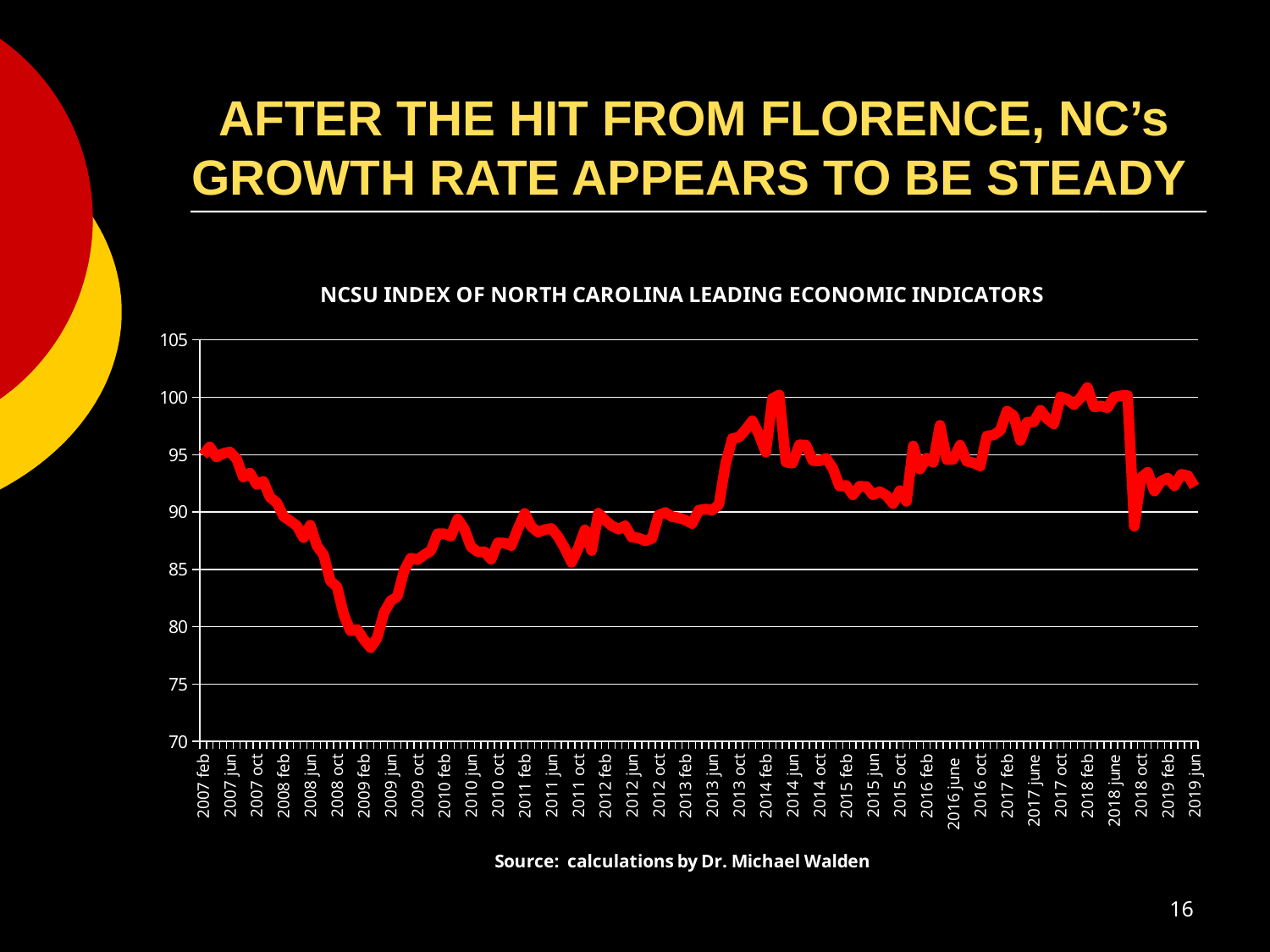
Is the value of the index at 2019 jun greater or less than 95? less Does the index rise or fall between 2007 feb and 2009 feb? fall Is the value of the index at 2011 oct greater or less than 90? less What kind of chart is shown on the slide? line chart Which is higher, the index at 2009 feb or at 2012 feb? 2012 feb What colour is the line plotted on the chart? red Is the value of the index at 2018 feb greater or less than 95? greater How many lines (series) are plotted on the chart? 1 What is the title of the chart? NCSU INDEX OF NORTH CAROLINA LEADING ECONOMIC INDICATORS Around which date does the index reach its lowest point? 2009 feb